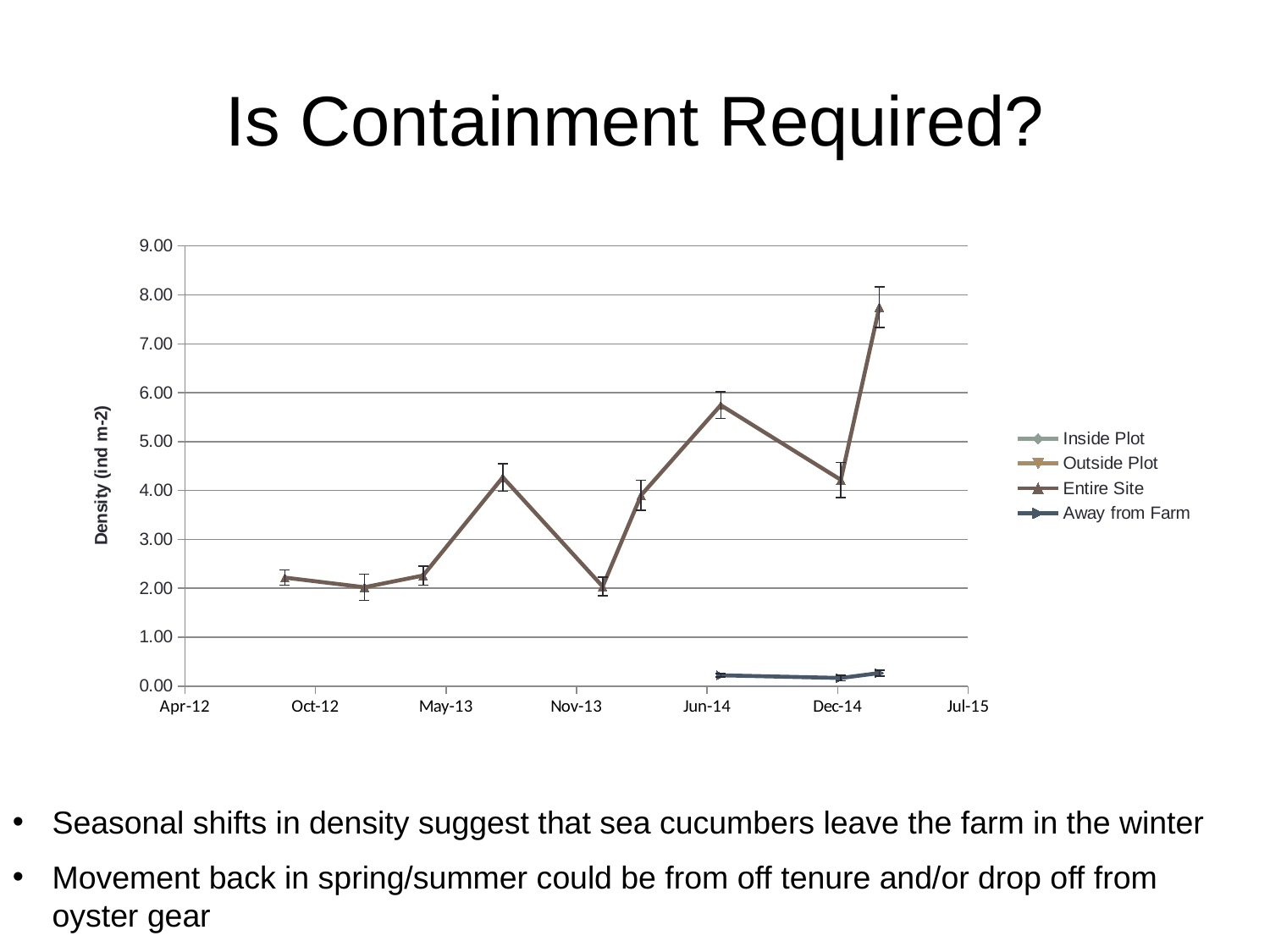
Around Jun-14, which series has the larger value, Entire Site or Away from Farm? Entire Site Is the value of the Entire Site series at its first plotted point (around Sep-12) greater or less than 3.00? less How many series does the legend list? 4 At which point in time does the Entire Site series reach its highest value? the last point, in early 2015 (between Dec-14 and Jul-15) What is the title of the slide containing the chart? Is Containment Required? What is the label on the vertical axis of the chart? Density (ind m-2) Are the values of the Away from Farm series greater or less than 1.00? less What kind of chart is shown on the slide? line chart Is the highest value of the Entire Site series greater or less than 7.00? greater Overall, does the Entire Site series rise or fall from its first point to its last point? rise How many data points are plotted for the Away from Farm series? 3